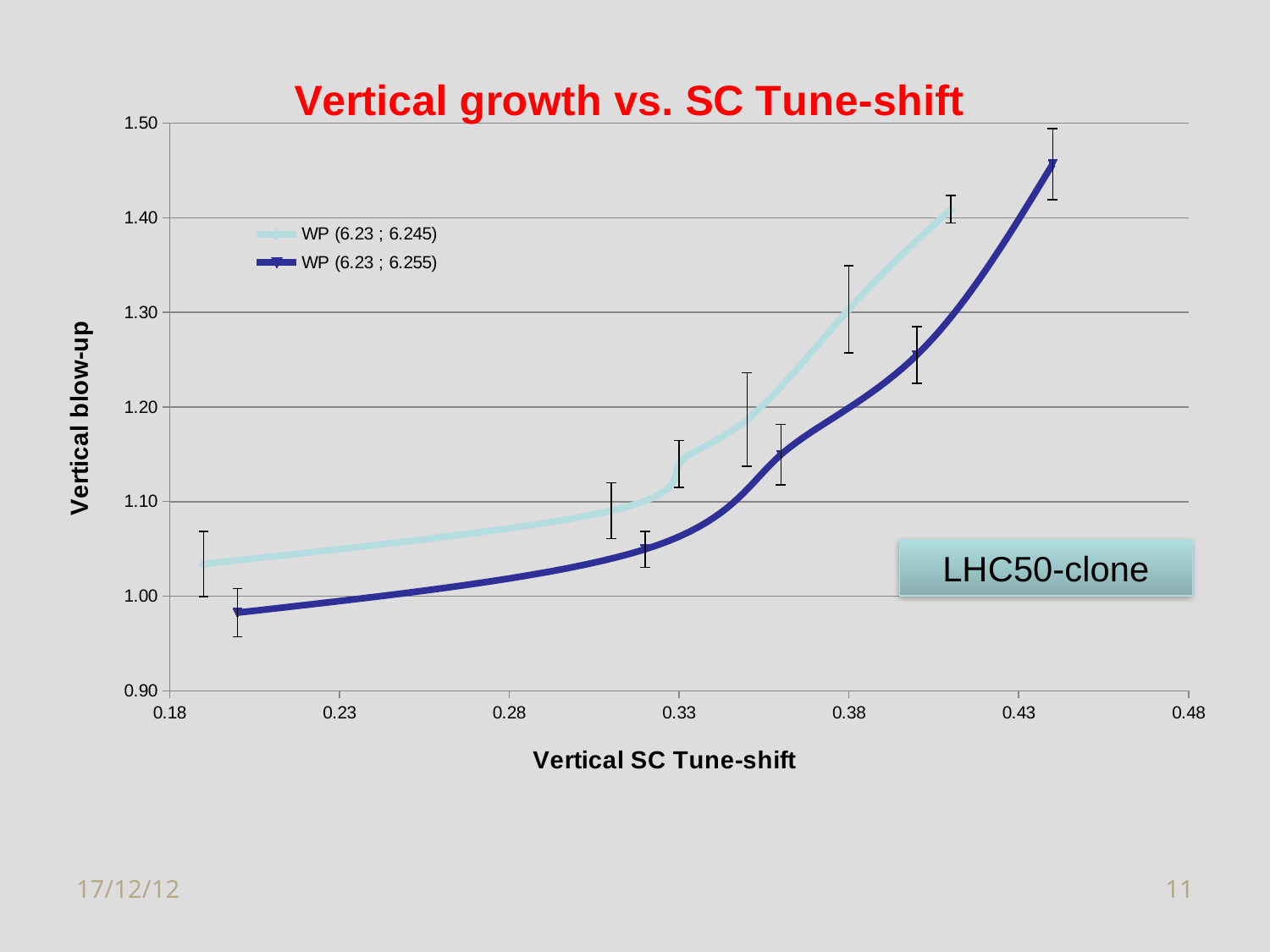
Does the vertical blow-up for the WP (6.23 ; 6.245) series rise or fall along the x axis? Rise Does the vertical blow-up for the WP (6.23 ; 6.255) series rise or fall as the vertical SC tune-shift increases? Rise Is the first (leftmost) value of the WP (6.23 ; 6.255) series greater or less than 1.00? less Is the value of the WP (6.23 ; 6.255) series at a vertical SC tune-shift of about 0.40 greater or less than 1.20? greater At a vertical SC tune-shift of about 0.33, which series has the higher vertical blow-up? WP (6.23 ; 6.245) What kind of chart is shown on the slide? Line chart What is the label of the vertical axis? Vertical blow-up What is the title of the chart? Vertical growth vs. SC Tune-shift How many series does the legend list? 2 Is the highest value of the WP (6.23 ; 6.255) series greater or less than 1.40? greater Which series reaches the highest vertical blow-up on the chart? WP (6.23 ; 6.255)